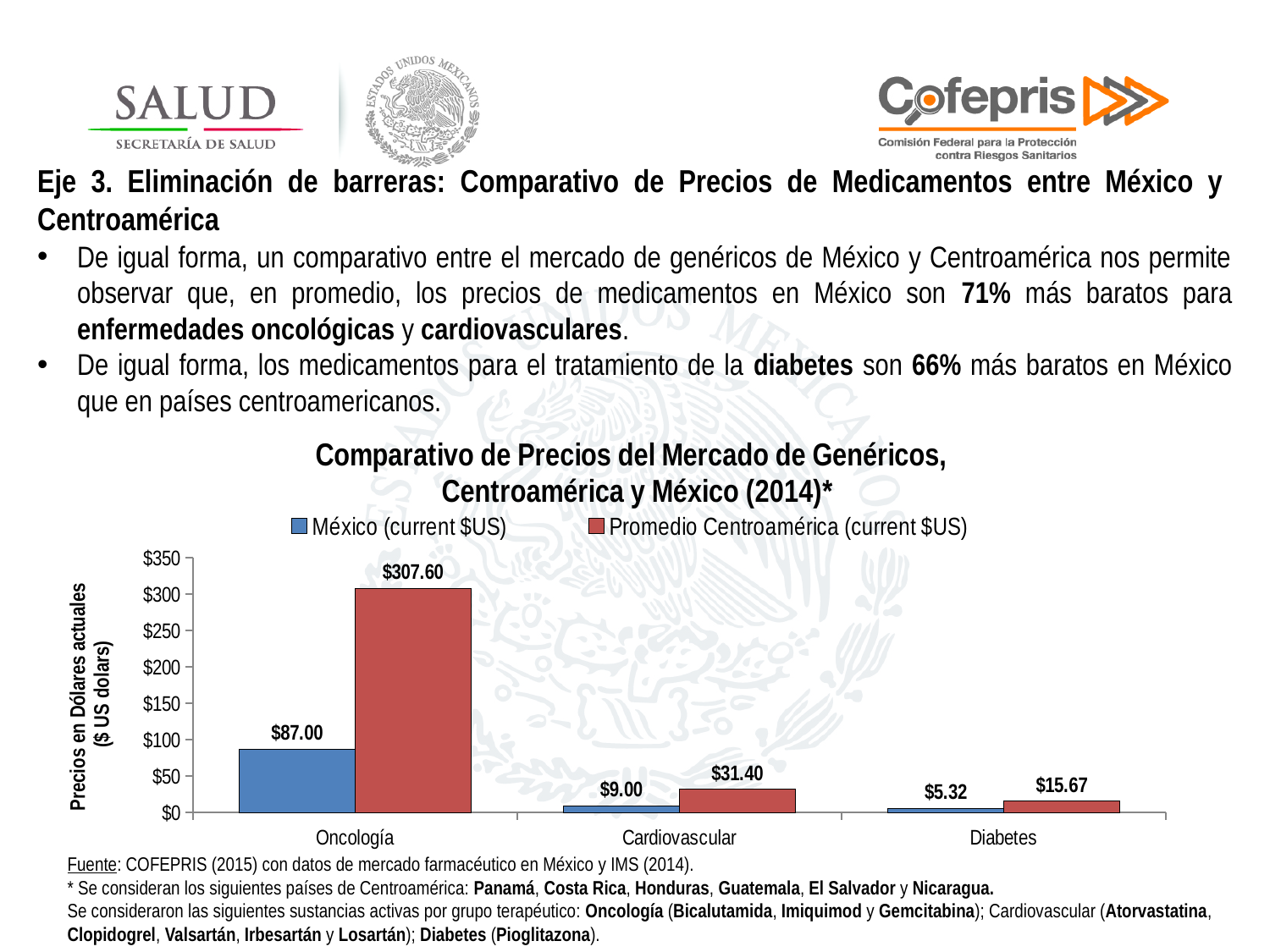
Which category has the highest value for Promedio Centroamérica (current $US)? Oncología What is the value for Promedio Centroamérica (current $US) in the Oncología category? $307.60 How many categories are shown on the x axis? 3 What is the value for México (current $US) in the Diabetes category? $5.32 Is the value for Promedio Centroamérica in the Oncología category greater or less than $300? greater What is the value for México (current $US) in the Oncología category? $87.00 Which category has the lowest value for México (current $US)? Diabetes What is the difference between the Promedio Centroamérica and México values in the Cardiovascular category? $22.40 How many series does the legend list? 2 What kind of chart is shown on the slide? Bar chart What is the value for Promedio Centroamérica (current $US) in the Cardiovascular category? $31.40 Which is larger in the Diabetes category: the México value or the Promedio Centroamérica value? Promedio Centroamérica